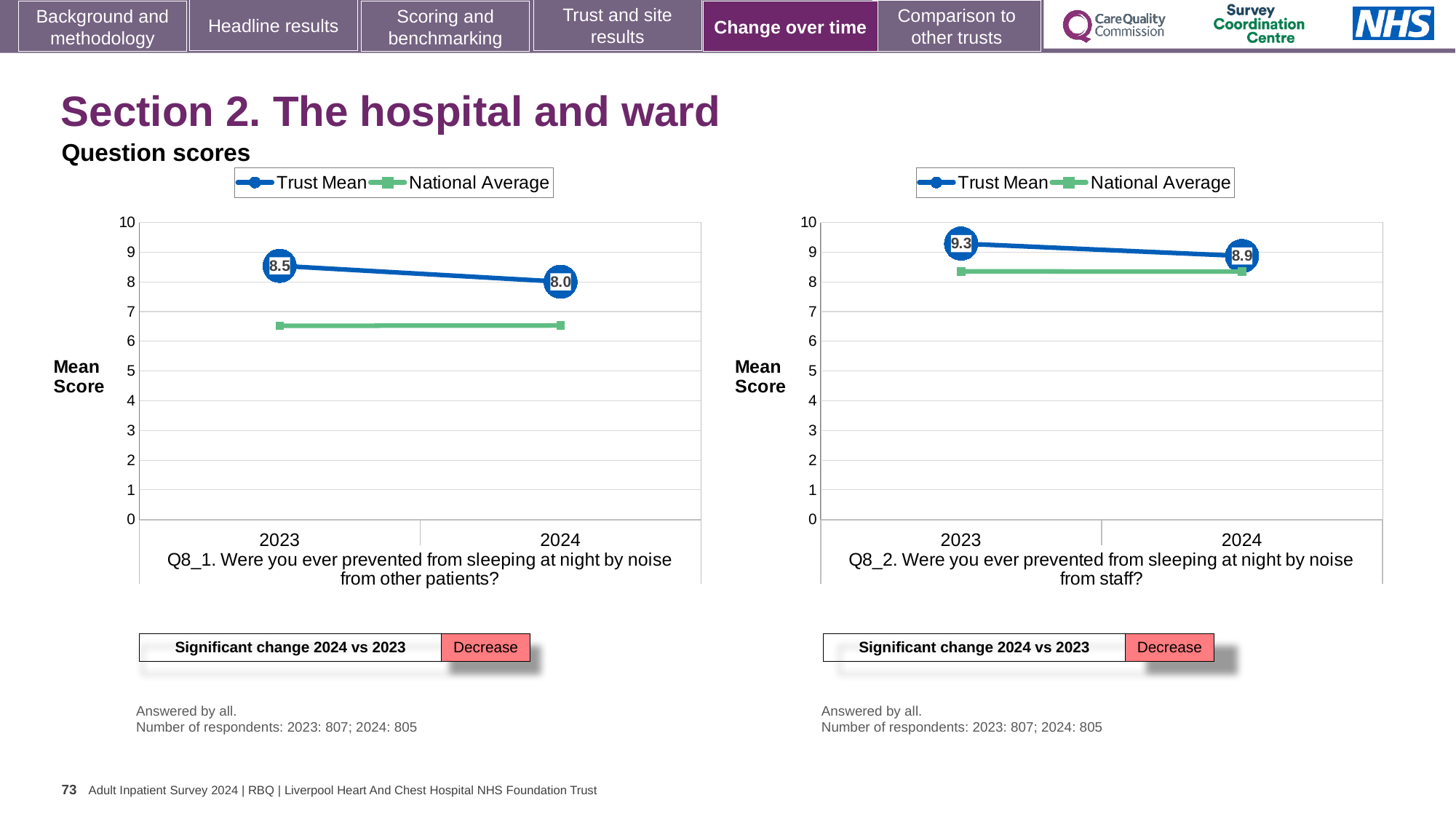
How many years are shown on the x axis of the left chart (Q8_1)? 2 How many series does the legend of the left chart list? 2 In the right chart (Q8_2), what is the difference between the Trust Mean in 2023 and 2024? 0.4 In the left chart (Q8_1), does the Trust Mean rise or fall from 2023 to 2024? fall In the left chart (Q8_1), what is the Trust Mean score for 2024? 8.0 In the right chart (Q8_2), what is the Trust Mean score for 2023? 9.3 In the left chart (Q8_1), is the National Average value for 2023 greater or less than 7? less In the right chart (Q8_2), which is higher in 2024, the Trust Mean or the National Average? Trust Mean In the left chart (Q8_1), by how much did the Trust Mean change from 2023 to 2024? 0.5 In the left chart (Q8_1), what is the Trust Mean score for 2023? 8.5 In the right chart (Q8_2), what is the Trust Mean score for 2024? 8.9 What kind of chart is the right chart (Q8_2)? line chart